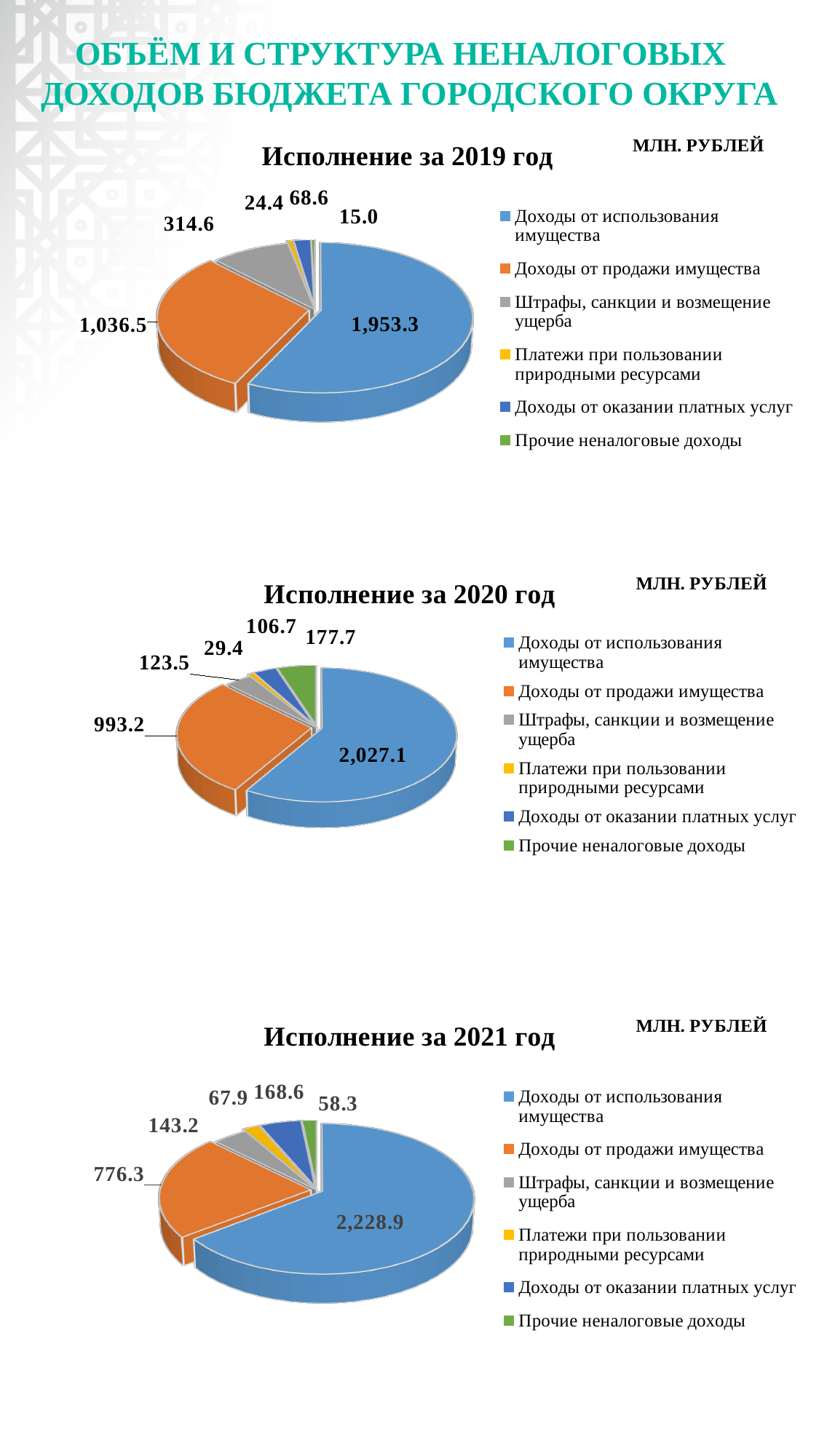
In the 'Исполнение за 2021 год' chart, what is the difference between Доходы от использования имущества and Доходы от продажи имущества? 1,452.6 In the 'Исполнение за 2021 год' chart, which category has the largest value? Доходы от использования имущества Which is larger: Доходы от использования имущества in the 2019 chart or in the 2021 chart? 2021 chart (2,228.9) In the 'Исполнение за 2019 год' chart, what is the difference between Доходы от продажи имущества and Штрафы, санкции и возмещение ущерба? 721.9 In the 'Исполнение за 2020 год' chart, what is the value for Прочие неналоговые доходы? 177.7 In the 'Исполнение за 2019 год' chart, what is the value for Доходы от использования имущества? 1,953.3 In the 'Исполнение за 2020 год' chart, what is the value for Доходы от продажи имущества? 993.2 In the 'Исполнение за 2021 год' chart, what is the value for Штрафы, санкции и возмещение ущерба? 143.2 How many categories does the legend of the 'Исполнение за 2020 год' chart list? 6 In the 'Исполнение за 2019 год' chart, which category has the smallest value? Прочие неналоговые доходы What type of chart is used for 'Исполнение за 2021 год'? Pie chart In the 'Исполнение за 2020 год' chart, which is larger: Доходы от оказании платных услуг or Прочие неналоговые доходы? Прочие неналоговые доходы